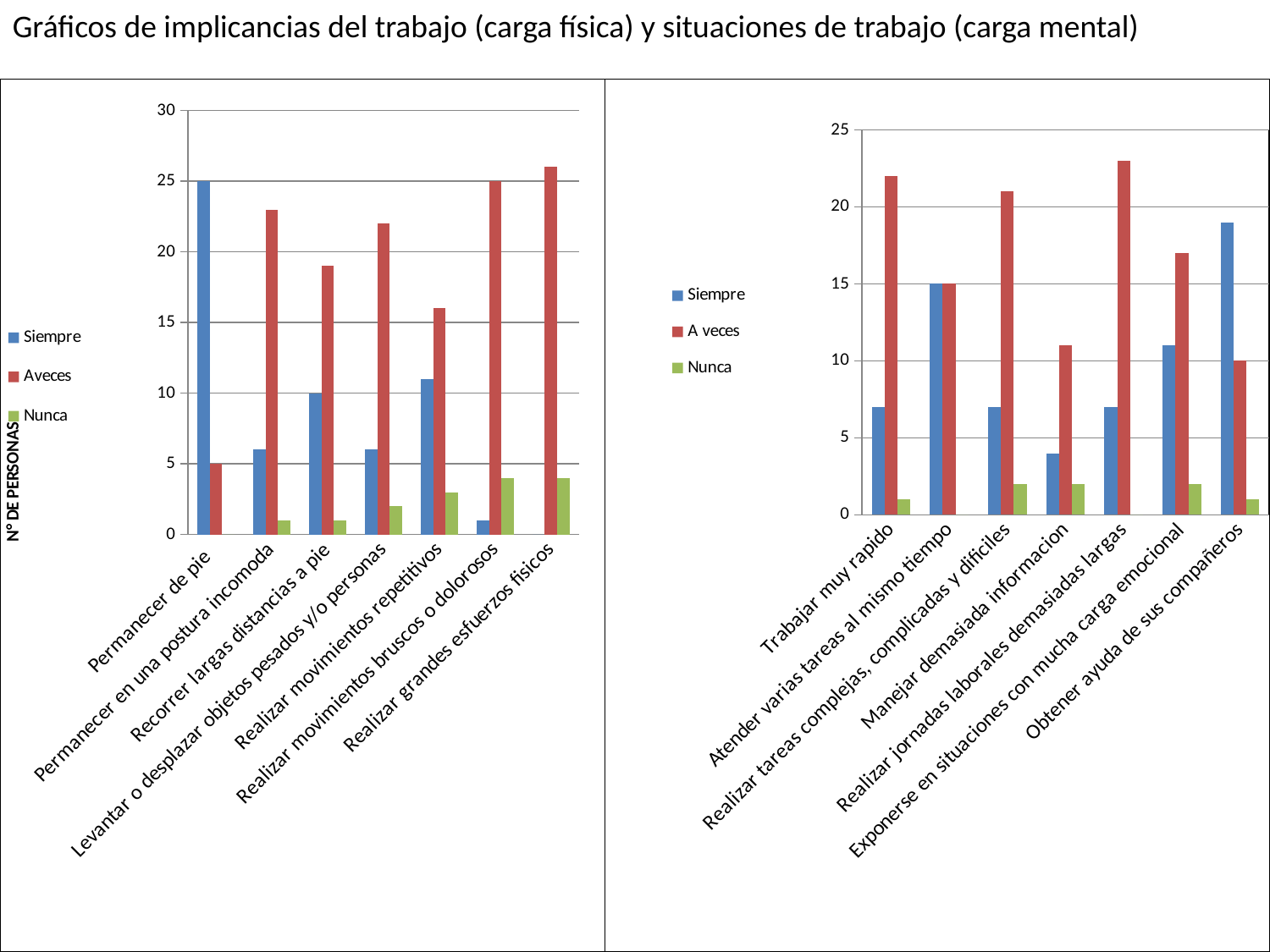
In the left chart, is the Aveces value for 'Realizar grandes esfuerzos fisicos' greater or less than 25? greater What kind of chart is the left chart? bar chart In the left chart, what is the value of the Siempre series for 'Permanecer de pie'? 25 In the right chart, is the A veces value for 'Realizar jornadas laborales demasiadas largas' greater or less than 20? greater In the left chart, which category has the highest Siempre value? Permanecer de pie In the right chart, what is the value of the A veces series for 'Obtener ayuda de sus compañeros'? 10 In the right chart, what is the value of the Siempre series for 'Atender varias tareas al mismo tiempo'? 15 In the right chart, how many series does the legend list? 3 In the left chart, what is the difference between the Siempre and Aveces values for 'Permanecer de pie'? 20 In the right chart, which category has the highest Siempre value? Obtener ayuda de sus compañeros In the left chart, what is the value of the Aveces series for 'Permanecer de pie'? 5 In the left chart, how many categories are shown on the x axis? 7